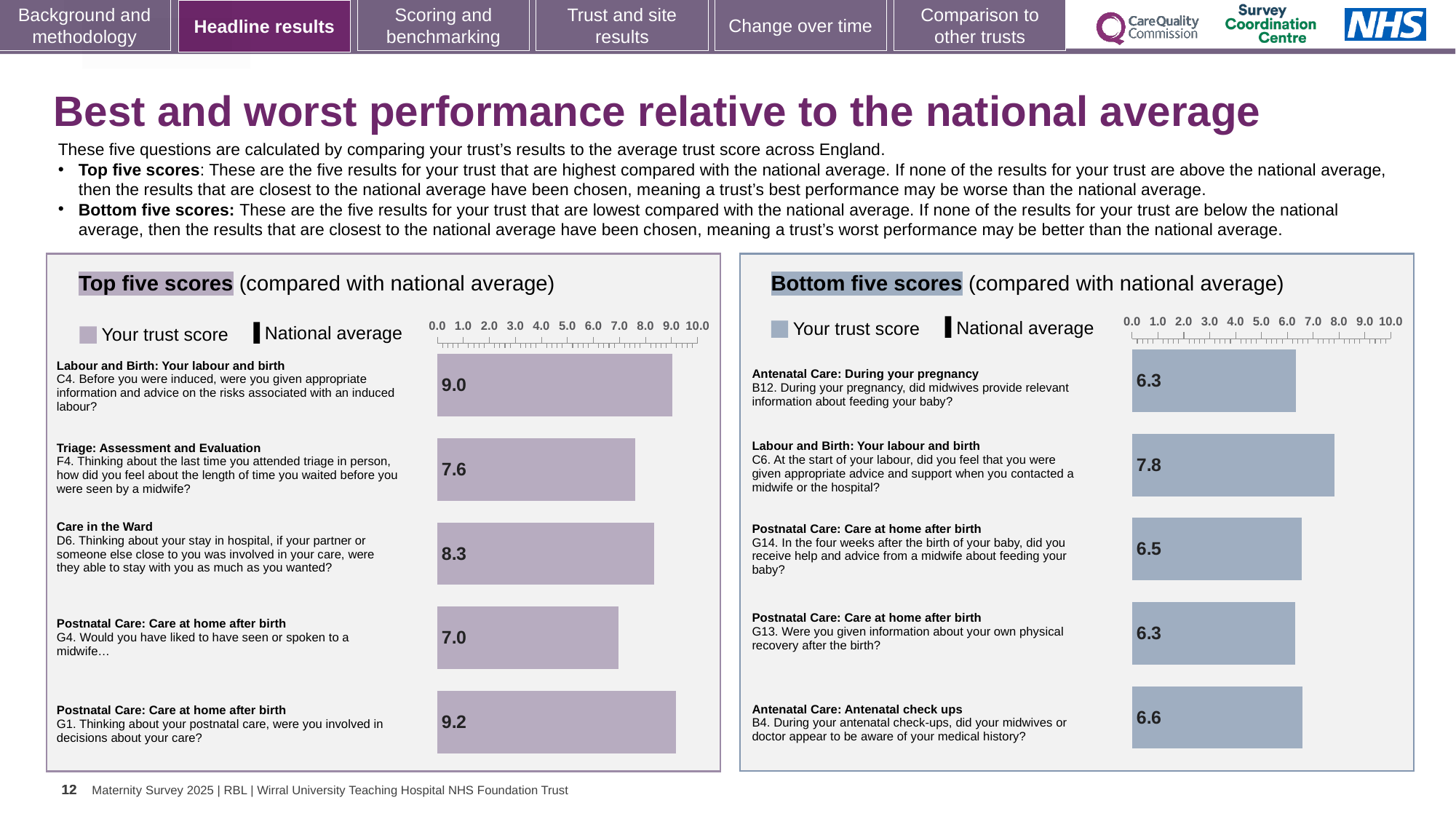
How many bars are plotted in the Top five scores chart? 5 How many series does the legend of the Bottom five scores chart list? 2 In the Bottom five scores chart, what is the trust score for question C6 about advice and support when you contacted a midwife or the hospital? 7.8 In the Top five scores chart, which question has the highest trust score? G1. Thinking about your postnatal care, were you involved in decisions about your care? In the Top five scores chart, which question has the lowest trust score? G4. Would you have liked to have seen or spoken to a midwife… In the Top five scores chart, what is the difference between the trust scores for G1 and G4? 2.2 In the Top five scores chart, what is the trust score for question C4 about information and advice on the risks of an induced labour? 9.0 In the Bottom five scores chart, what is the difference between the trust scores for C6 and B12? 1.5 In the Bottom five scores chart, which has the larger trust score: G14 or B4? B4 What kind of chart is the Top five scores chart? Bar chart In the Bottom five scores chart, which question has the highest trust score? C6. At the start of your labour, did you feel that you were given appropriate advice and support when you contacted a midwife or the hospital? In the Top five scores chart, is the trust score for D6 greater or less than 8.0? greater